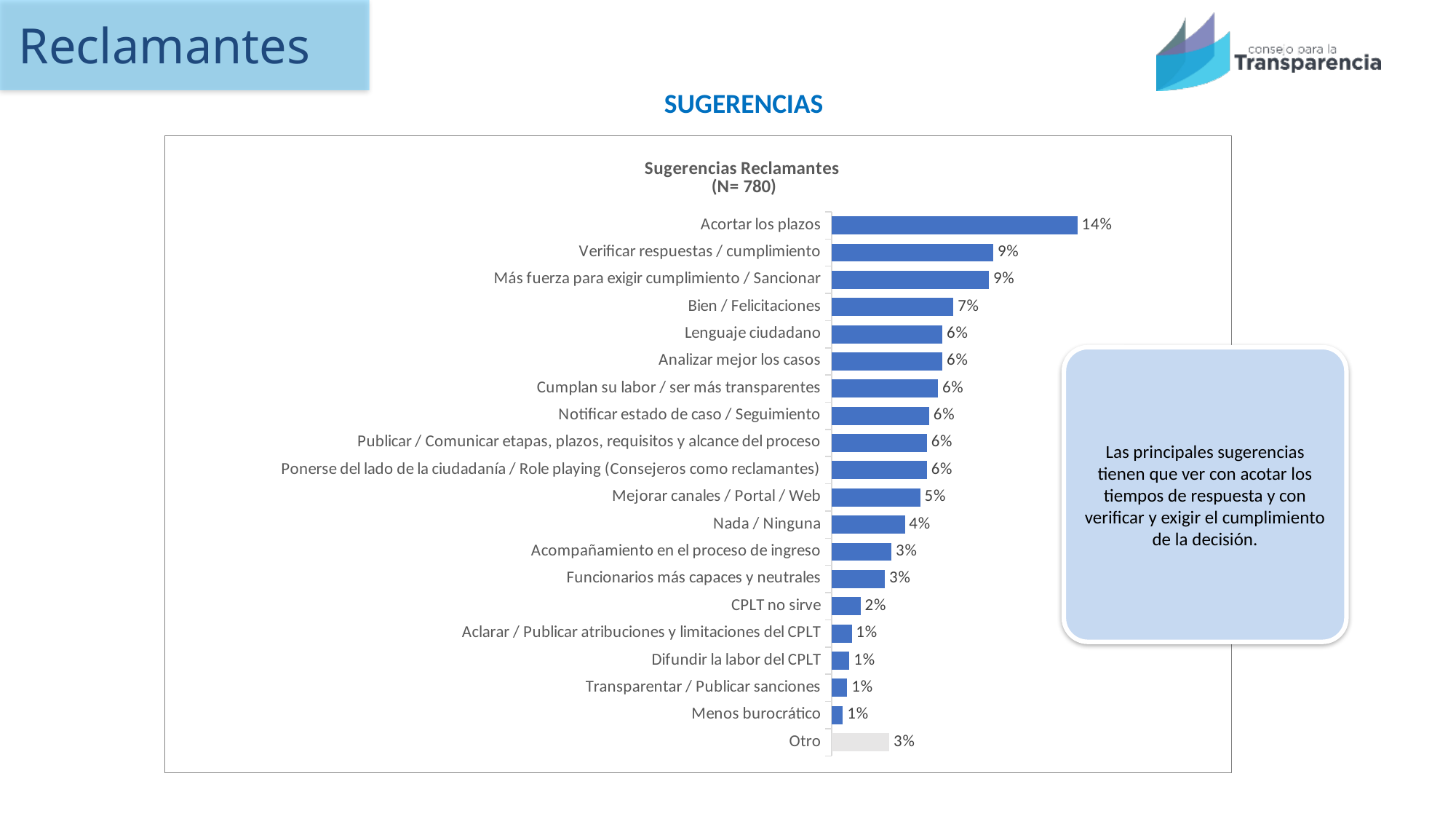
What is the value for "Mejorar canales / Portal / Web"? 5% What is the value for "Nada / Ninguna"? 4% What is the difference between "Bien / Felicitaciones" and "Nada / Ninguna"? 3% What is the value for "Acortar los plazos"? 14% What is the sample size (N) stated in the chart title? 780 What is the value for "CPLT no sirve"? 2% How many categories are shown in the chart? 20 What is the difference between "Acortar los plazos" and "Verificar respuestas / cumplimiento"? 5% Which is larger, "Bien / Felicitaciones" or "Lenguaje ciudadano"? Bien / Felicitaciones What is the value for "Otro"? 3% What kind of chart is shown? Bar chart Which category has the highest value? Acortar los plazos